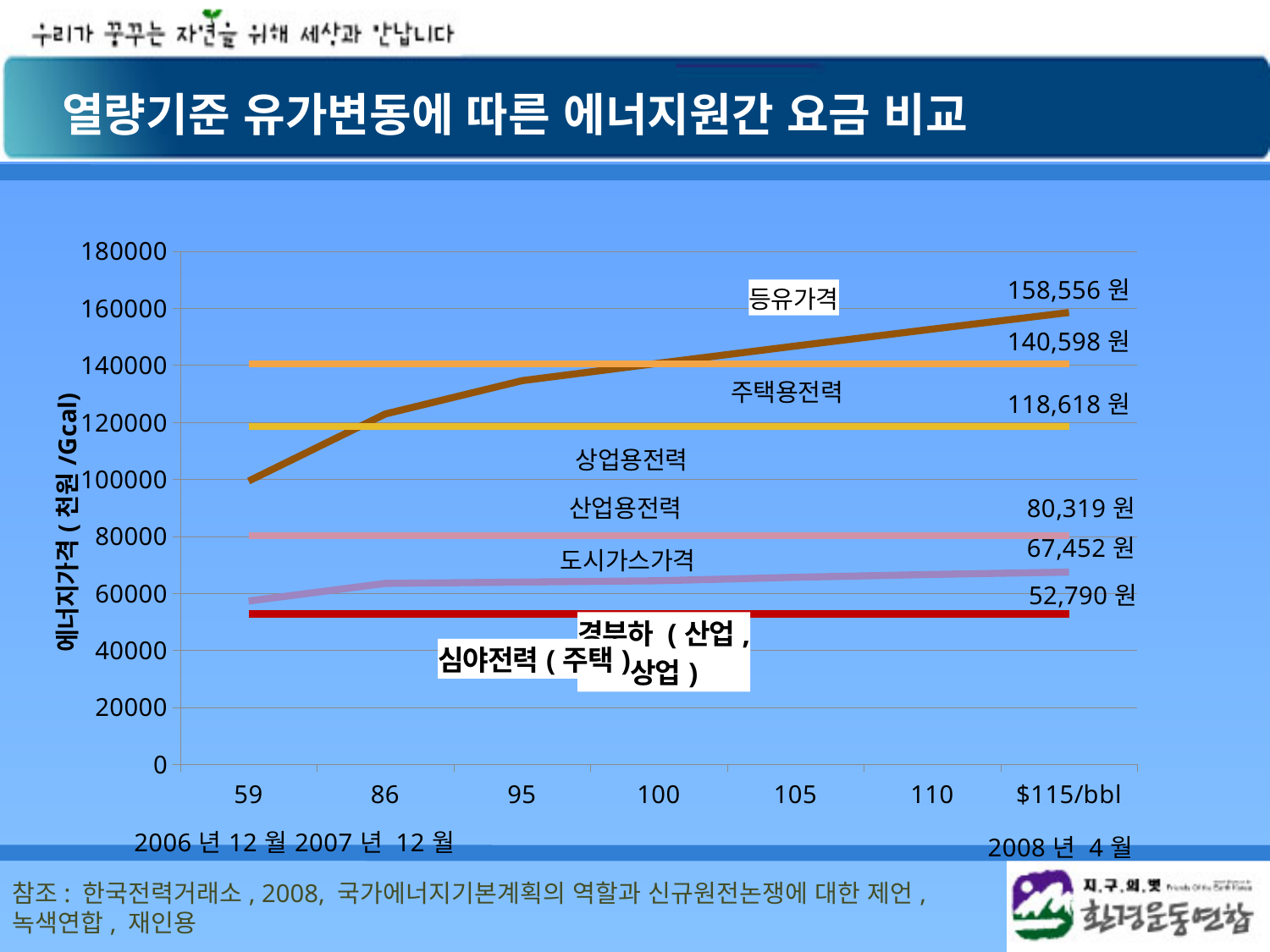
What is the value labelled for 주택용전력? 140,598 원 What kind of chart is shown on the slide? line chart What is the value labelled for the 심야전력(주택)/경부하(산업, 상업) line? 52,790 원 How many oil price points are shown on the x axis? 7 Which series has the highest value at $115/bbl? 등유가격 What is the value of 도시가스가격 at $115/bbl? 67,452 원 What is the difference between 등유가격 and 주택용전력 at $115/bbl? 17,958 원 What is the value labelled for 상업용전력? 118,618 원 Is the value of 등유가격 at an oil price of 59 greater or less than 120000? less Does 등유가격 rise or fall as the oil price increases along the x axis? rises What is the value labelled for 산업용전력? 80,319 원 What is the value of 등유가격 at $115/bbl? 158,556 원